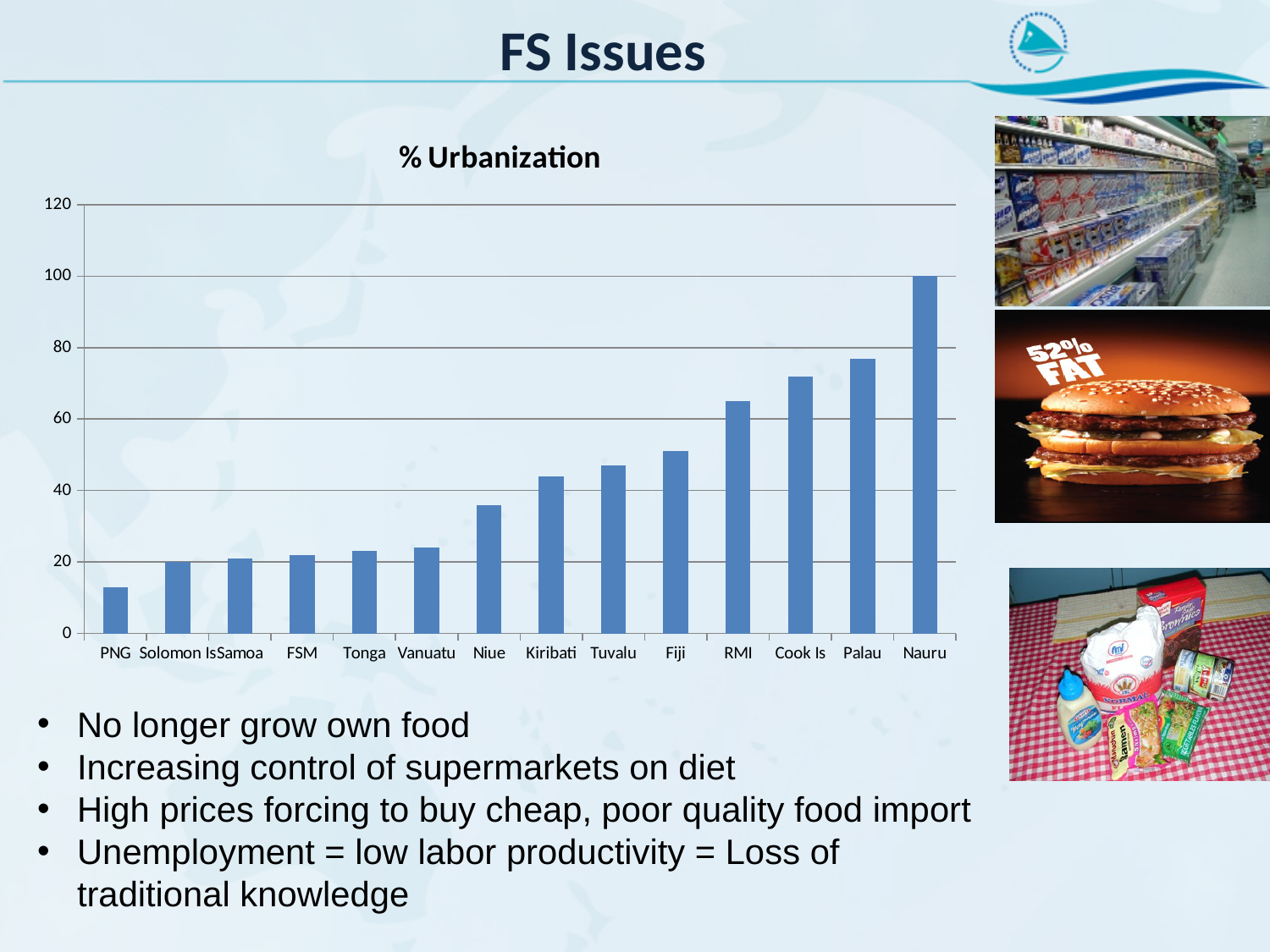
Which country has the highest % Urbanization? Nauru Which has a higher % Urbanization, Niue or Vanuatu? Niue Is the value for Palau greater or less than 80? less What kind of chart is shown on the slide? Bar chart How many countries are shown on the x axis of the chart? 14 Do the values generally rise or fall moving from left to right along the x axis? Rise Which country has the lowest % Urbanization? PNG What is the title of the chart? % Urbanization Is the value for RMI greater or less than 60? greater Is the value for PNG greater or less than 20? less What is the % Urbanization value for Nauru? 100